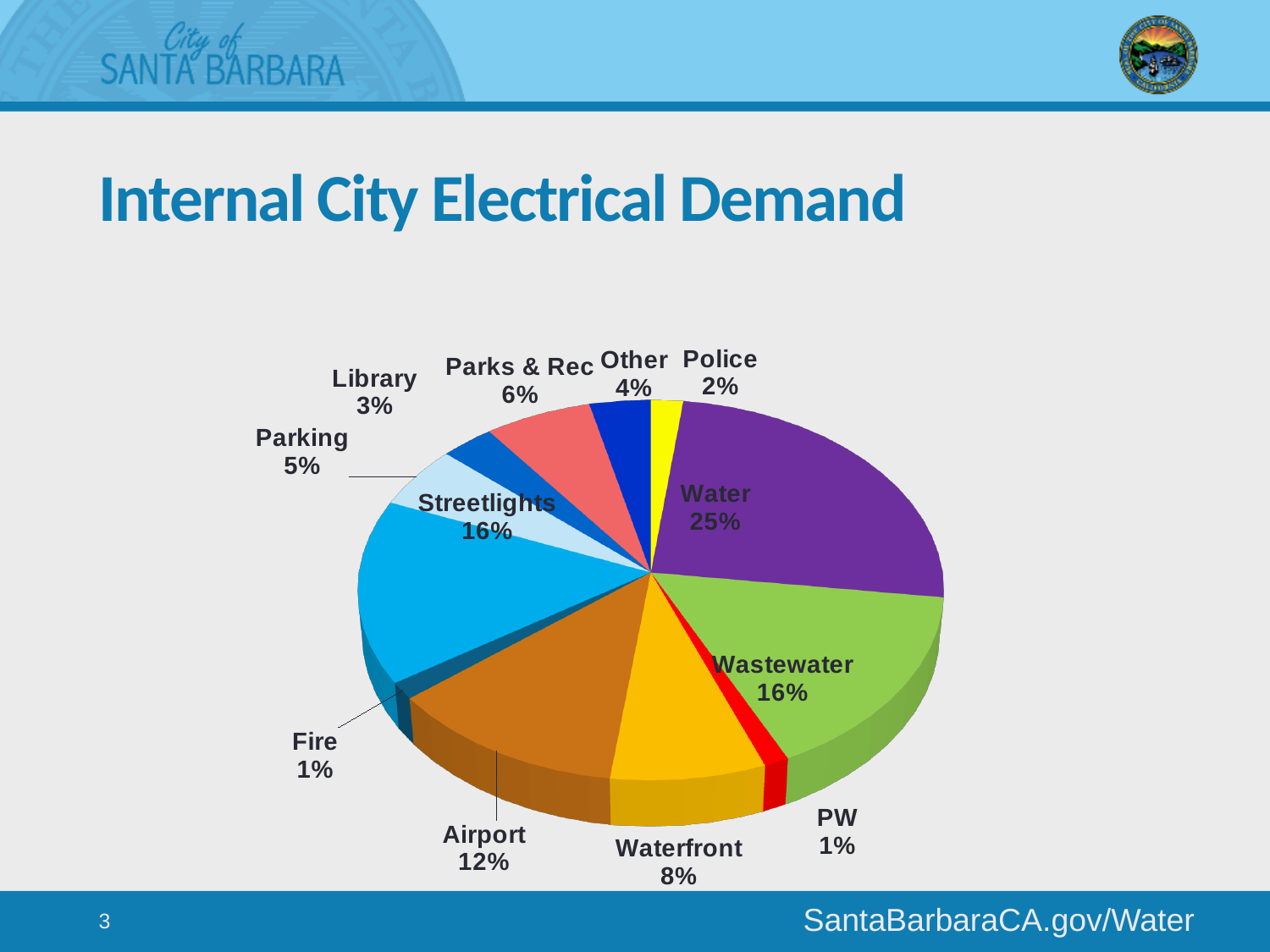
What kind of chart is shown on the slide? Pie chart What is the difference in percentage points between Water and Wastewater? 9 What is the value shown for Streetlights? 16% Which is larger, the share for Airport or the share for Waterfront? Airport What percentage of the pie is Airport? 12% What share of internal city electrical demand is attributed to Water? 25% Which is larger, the share for Parking or the share for Library? Parking What is the title of the chart on the slide? Internal City Electrical Demand What is the combined share of Water and Wastewater? 41% Which category has the largest share of the pie? Water What percentage is shown for Parks & Rec? 6% How many categories are shown in the pie chart? 12